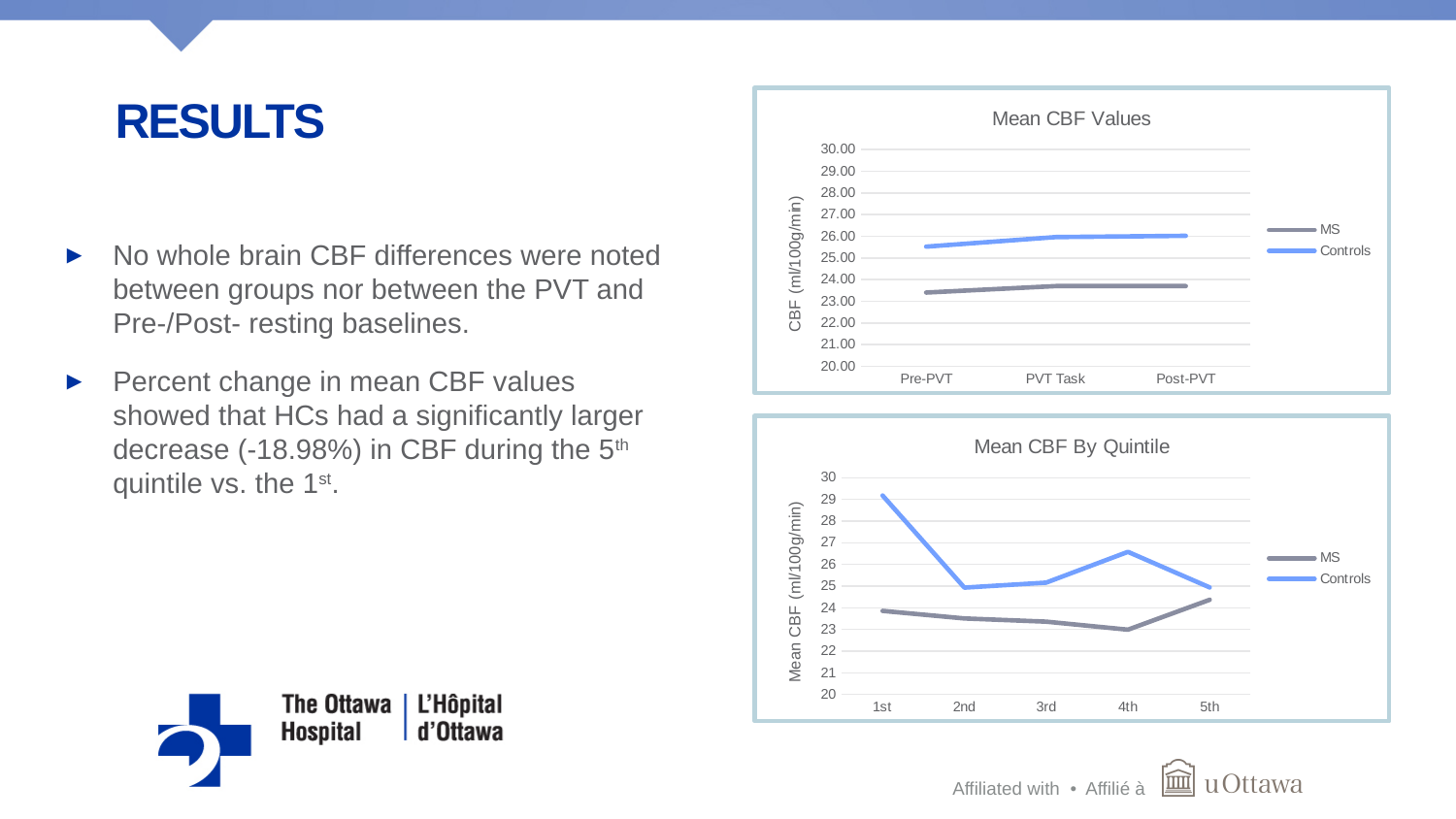
How many quintiles are shown on the x axis of the "Mean CBF By Quintile" chart? 5 In the "Mean CBF Values" chart, which series has the higher value at Pre-PVT, MS or Controls? Controls How many categories are on the x axis of the "Mean CBF Values" chart? 3 In the "Mean CBF By Quintile" chart, is the Controls value at the 1st quintile greater or less than 28? greater What are the two legend entries in the "Mean CBF By Quintile" chart? MS and Controls In the "Mean CBF Values" chart, is the MS value at Pre-PVT greater or less than 24.00? less How many series does the legend of the "Mean CBF Values" chart list? 2 In the "Mean CBF By Quintile" chart, at which quintile is the MS value lowest? 4th In the "Mean CBF By Quintile" chart, does the Controls line rise or fall from the 1st to the 2nd quintile? fall What kind of chart is the "Mean CBF Values" chart? line chart In the "Mean CBF By Quintile" chart, at which quintile is the Controls value highest? 1st In the "Mean CBF Values" chart, is the Controls value at PVT Task greater or less than 25.00? greater